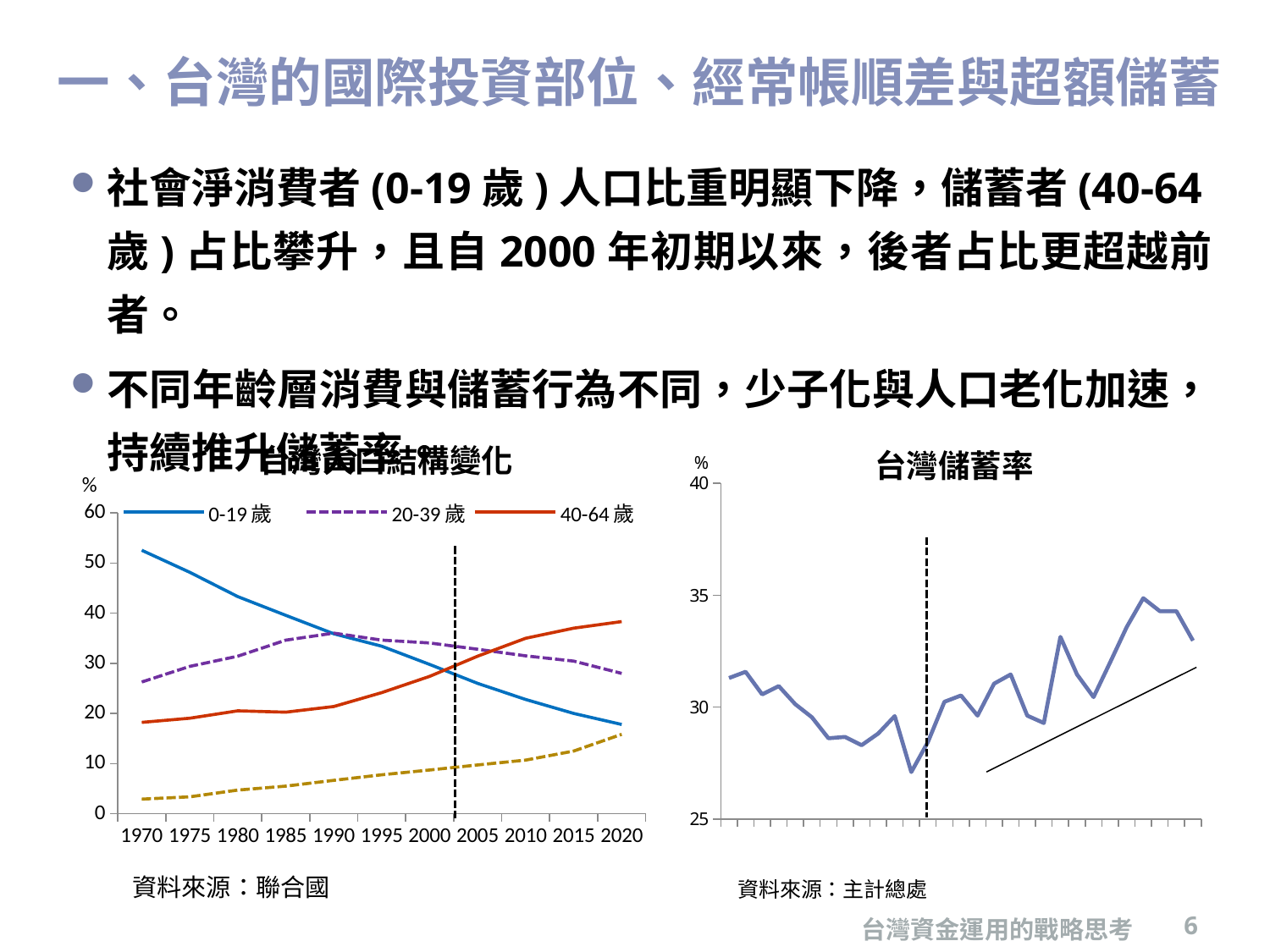
In the left chart, which is larger in 2020, 0-19歲 or 40-64歲? 40-64歲 In the left chart, is the value for 0-19歲 in 2020 greater or less than 20? less What is the title of the right chart? 台灣儲蓄率 How many series does the legend of the left chart list? 3 In the right chart titled 台灣儲蓄率, is the lowest point of the line greater or less than 30? less What kind of chart is the left chart on the slide? line chart In the left chart, is the value for 40-64歲 in 1970 greater or less than 20? less In the left chart, does the 0-19歲 line rise or fall from 1970 to 2020? fall What kind of chart is the right chart titled 台灣儲蓄率? line chart In the left chart, does the 40-64歲 line rise or fall from 1970 to 2020? rise